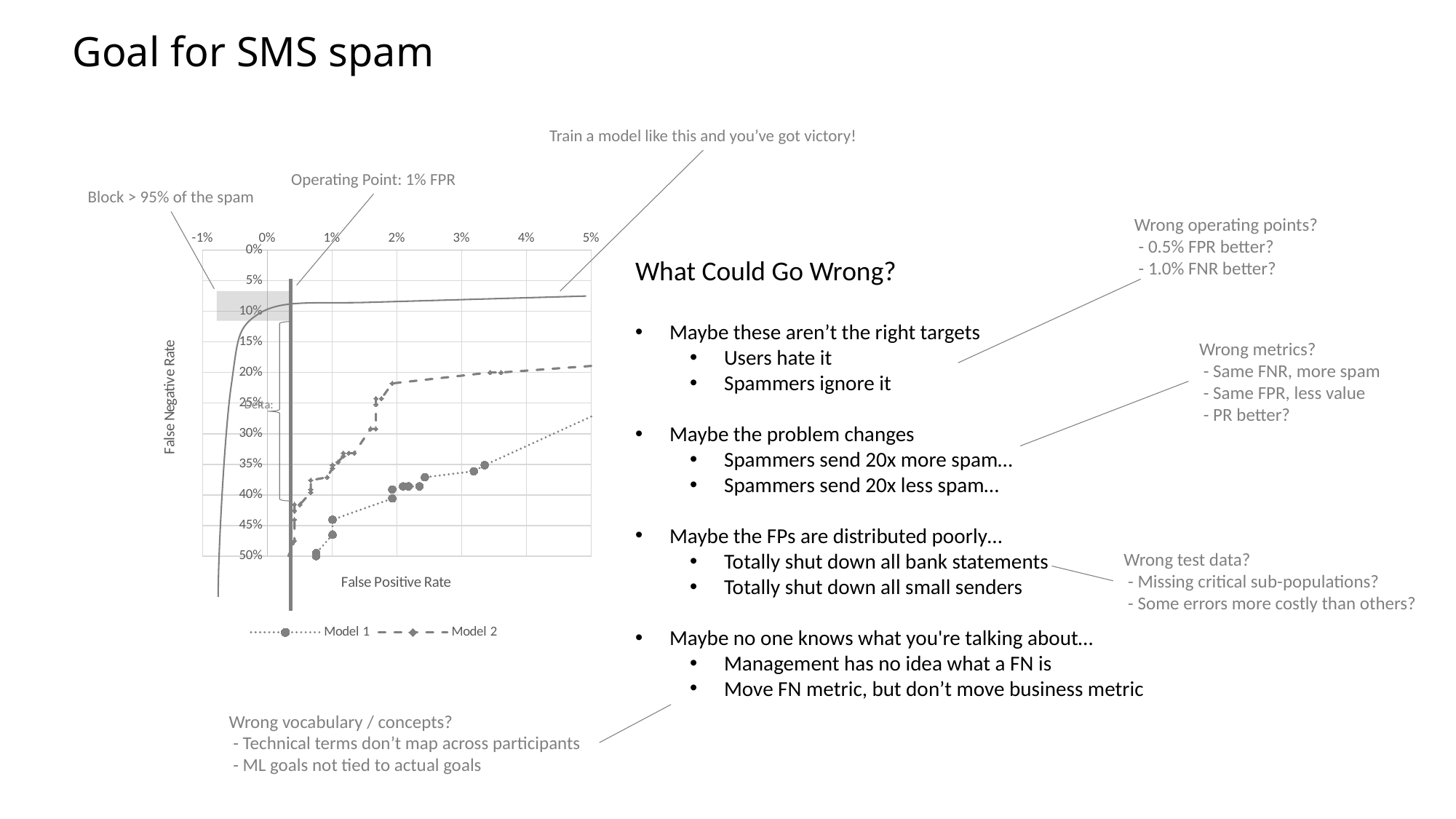
What is the highest value shown on the chart's x axis? 5% What is the title of the chart's vertical axis? False Negative Rate Is the False Negative Rate for Model 1 at a 1% False Positive Rate greater or less than 40%? greater Is the False Negative Rate for Model 1 at a 5% False Positive Rate greater or less than 25%? greater Is the False Negative Rate for Model 2 at a 4% False Positive Rate greater or less than 25%? less How many series does the chart legend list? 2 As the False Positive Rate increases along the x axis, does the False Negative Rate for Model 2 rise or fall? fall At a False Positive Rate of 3%, which series has the lower False Negative Rate, Model 1 or Model 2? Model 2 As the False Positive Rate increases along the x axis, does the False Negative Rate for Model 1 rise or fall? fall What are the names of the two series in the chart legend? Model 1 and Model 2 What kind of chart is shown on the slide? line chart